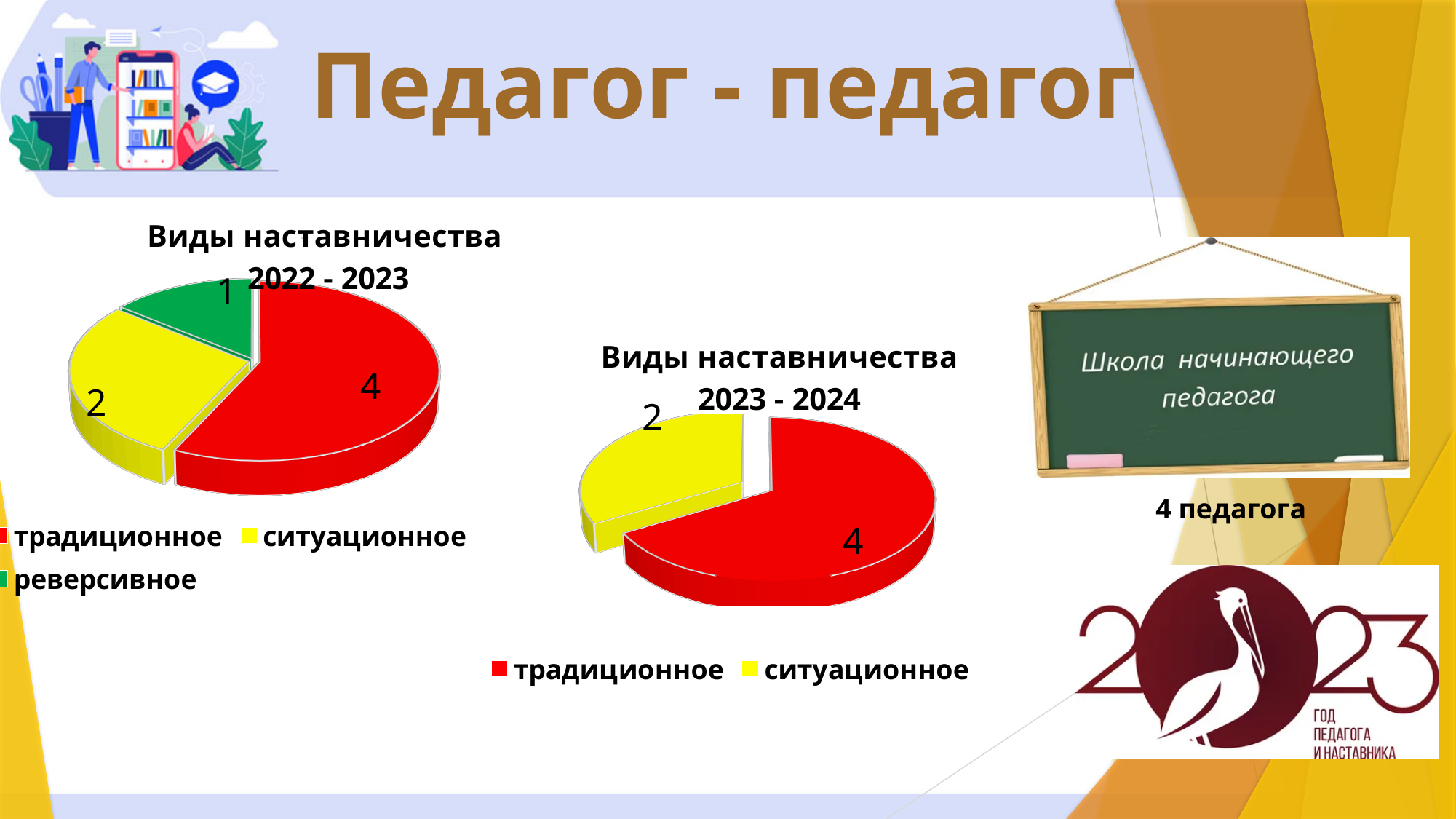
What kind of chart is the chart titled 'Виды наставничества 2023 - 2024'? pie chart In the chart titled 'Виды наставничества 2023 - 2024', what is the difference between традиционное and ситуационное? 2 In the chart titled 'Виды наставничества 2023 - 2024', which category has the smallest slice? ситуационное How many categories does the chart titled 'Виды наставничества 2023 - 2024' show? 2 In the chart titled 'Виды наставничества 2022 - 2023', which category has the largest slice? традиционное In the chart titled 'Виды наставничества 2022 - 2023', what is the difference between традиционное and ситуационное? 2 In the chart titled 'Виды наставничества 2023 - 2024', what is the value for ситуационное? 2 In the chart titled 'Виды наставничества 2022 - 2023', which category has the smallest slice? реверсивное In the chart titled 'Виды наставничества 2022 - 2023', what is the value for реверсивное? 1 In the chart titled 'Виды наставничества 2022 - 2023', what is the value for традиционное? 4 How many categories does the chart titled 'Виды наставничества 2022 - 2023' show? 3 In the chart titled 'Виды наставничества 2022 - 2023', which is larger: ситуационное or реверсивное? ситуационное